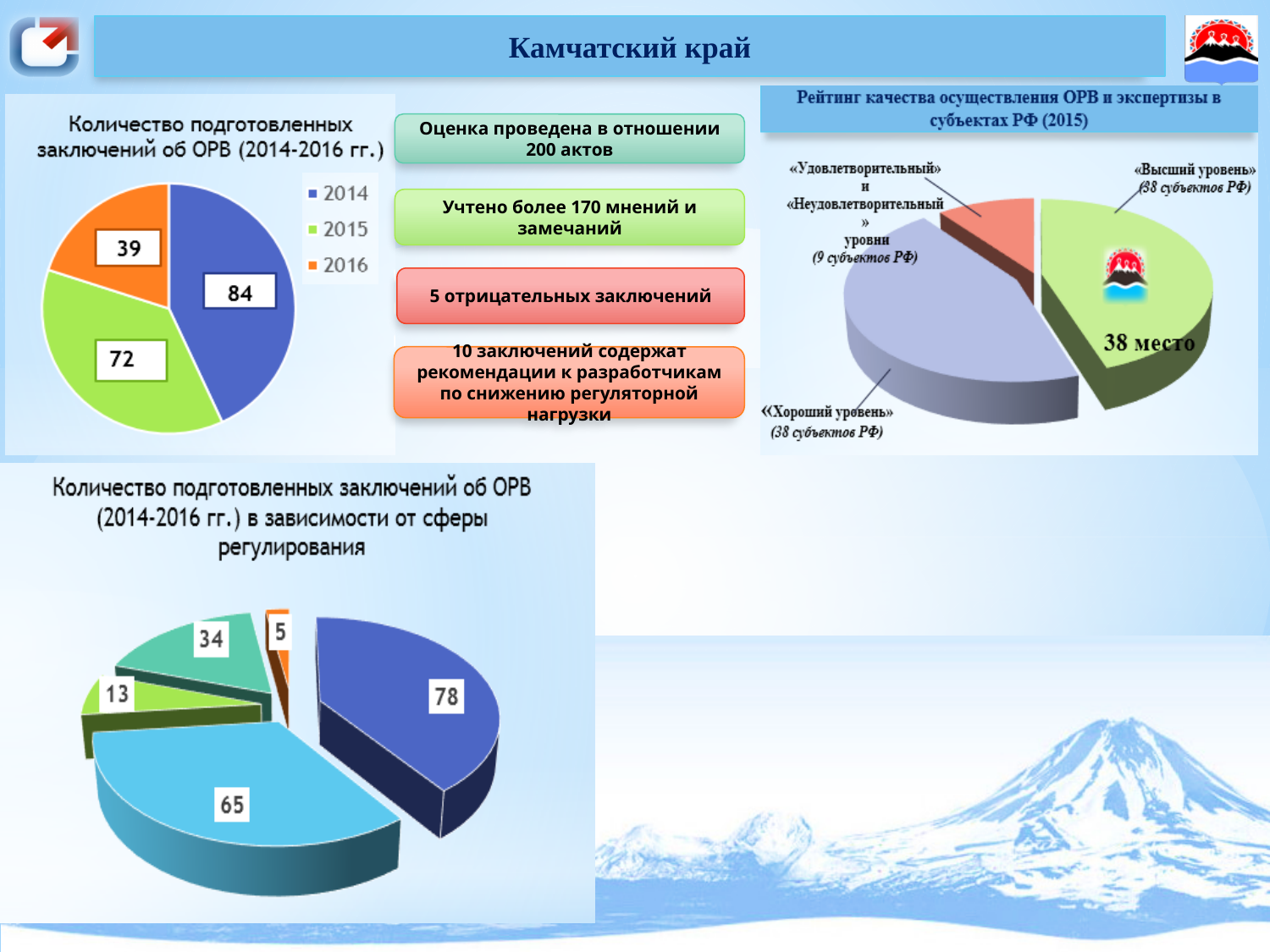
On the chart 'Рейтинг качества осуществления ОРВ и экспертизы в субъектах РФ (2015)', which level has the fewest subjects of the RF? «Удовлетворительный» и «Неудовлетворительный» уровни On the bottom-left chart 'Количество подготовленных заключений об ОРВ (2014-2016 гг.) в зависимости от сферы регулирования', what is the value of the largest slice? 78 On the chart 'Количество подготовленных заключений об ОРВ (2014-2016 гг.)', what is the difference between the values for 2014 and 2015? 12 On the chart 'Количество подготовленных заключений об ОРВ (2014-2016 гг.)', how many years does the legend list? 3 On the chart 'Количество подготовленных заключений об ОРВ (2014-2016 гг.)', which year has the smallest slice? 2016 On the chart 'Количество подготовленных заключений об ОРВ (2014-2016 гг.)', which year has the largest slice? 2014 On the chart 'Рейтинг качества осуществления ОРВ и экспертизы в субъектах РФ (2015)', how many subjects of the RF are in the 'Удовлетворительный' and 'Неудовлетворительный' levels? 9 субъектов РФ On the chart 'Количество подготовленных заключений об ОРВ (2014-2016 гг.)', what is the total of all three slices? 195 On the bottom-left chart 'Количество подготовленных заключений об ОРВ (2014-2016 гг.) в зависимости от сферы регулирования', how many slices does the pie have? 5 On the chart 'Количество подготовленных заключений об ОРВ (2014-2016 гг.)', what is the value for 2016? 39 What kind of chart is 'Рейтинг качества осуществления ОРВ и экспертизы в субъектах РФ (2015)'? pie chart On the chart 'Количество подготовленных заключений об ОРВ (2014-2016 гг.)', what is the value for 2014? 84